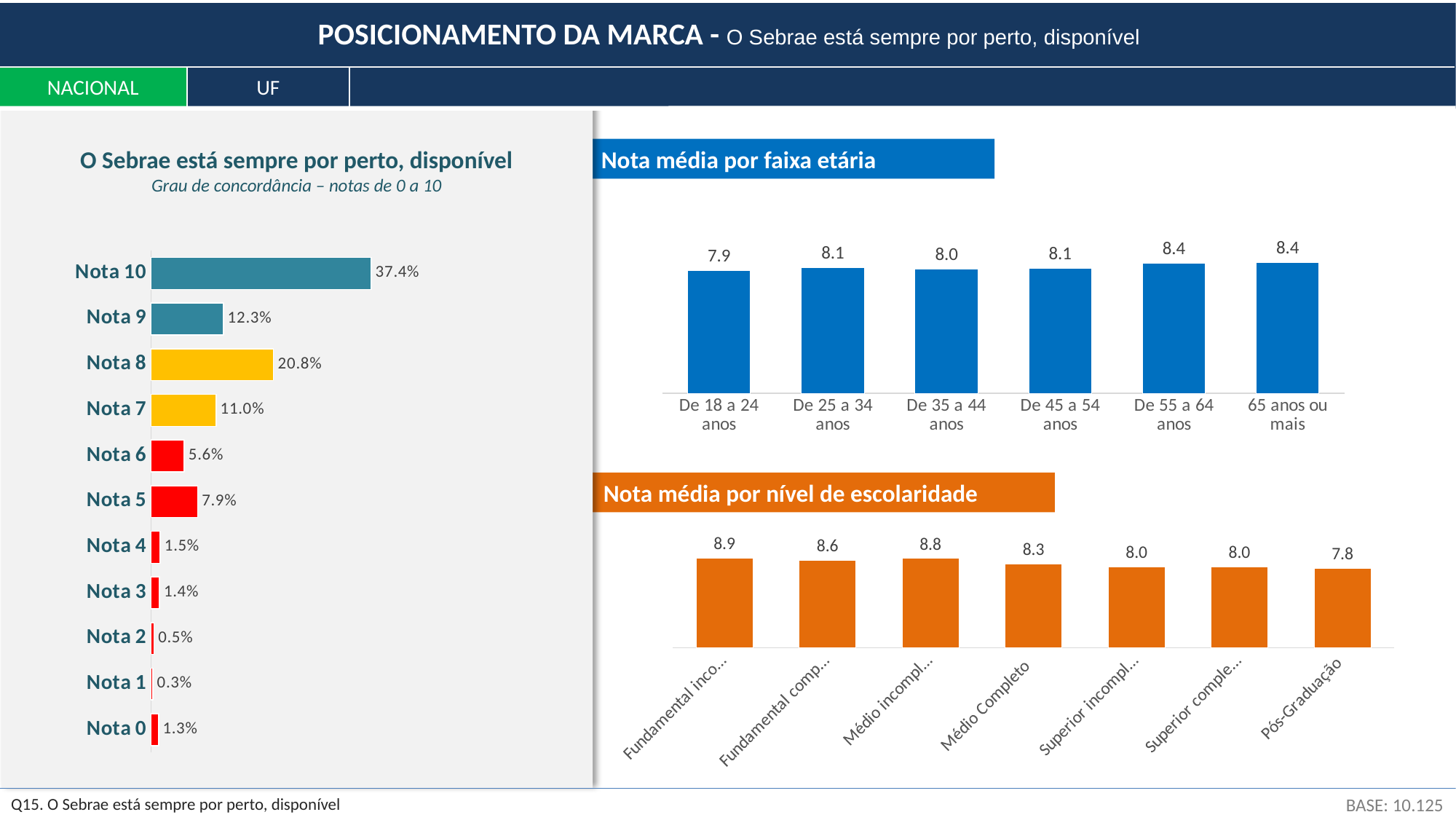
In the chart 'O Sebrae está sempre por perto, disponível', what percentage is shown for Nota 10? 37.4% In the chart 'O Sebrae está sempre por perto, disponível', which nota has the highest percentage? Nota 10 In the chart 'Nota média por faixa etária', how many age groups are shown? 6 In the chart 'O Sebrae está sempre por perto, disponível', how many notas (categories) are shown? 11 In the chart 'Nota média por nível de escolaridade', what is the value for 'Médio Completo'? 8.3 In the chart 'Nota média por faixa etária', which age group has the lowest average score? De 18 a 24 anos In the chart 'Nota média por nível de escolaridade', which is larger: the value for 'Médio Completo' or the value for 'Pós-Graduação'? Médio Completo In the chart 'Nota média por nível de escolaridade', which education level has the lowest average score? Pós-Graduação What type of chart is 'O Sebrae está sempre por perto, disponível'? Bar chart In the chart 'O Sebrae está sempre por perto, disponível', what is the difference between the percentages for Nota 8 and Nota 7? 9.8% In the chart 'Nota média por faixa etária', what is the value for 'De 18 a 24 anos'? 7.9 In the chart 'O Sebrae está sempre por perto, disponível', which nota has the lowest percentage? Nota 1